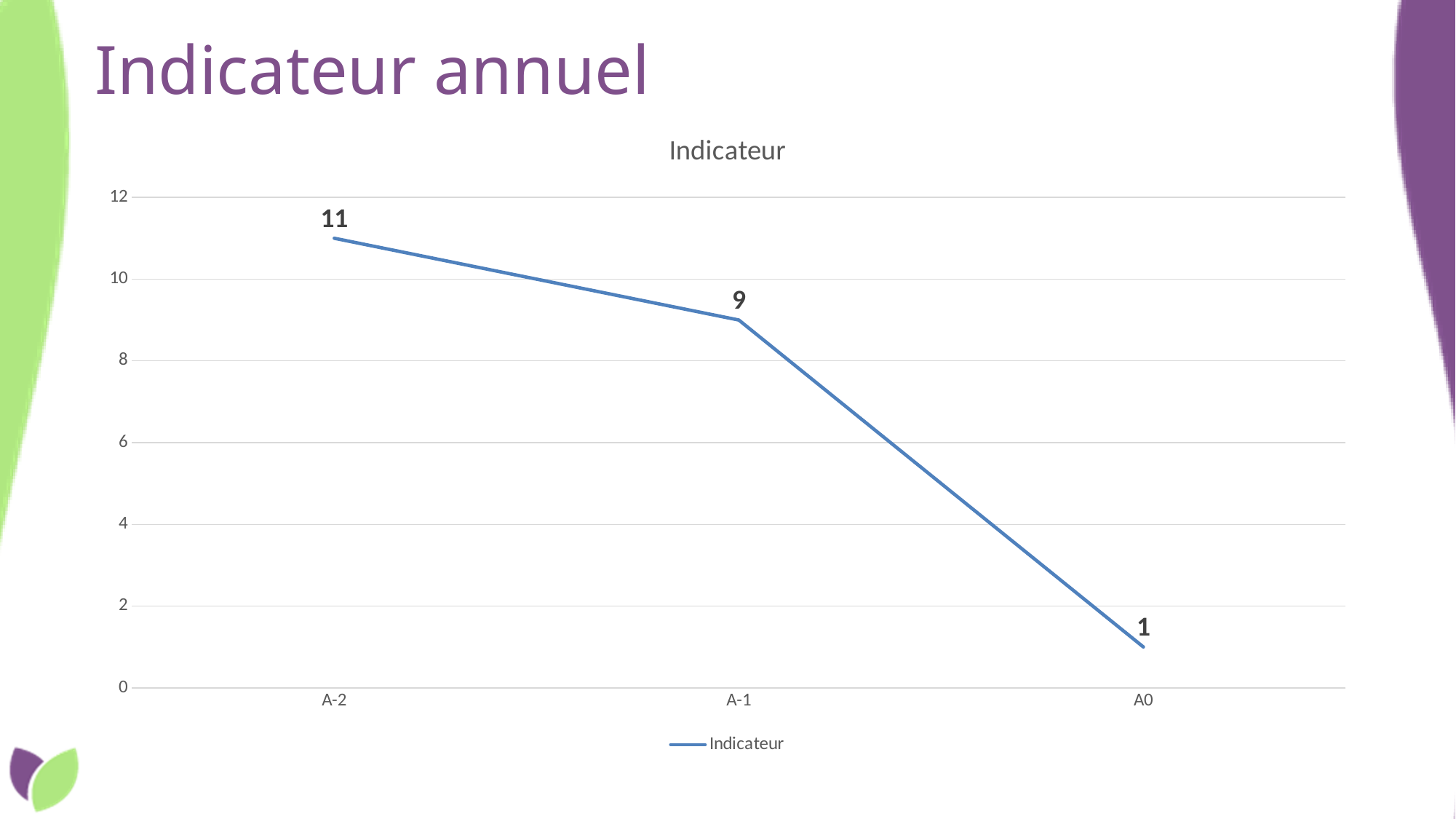
Which category has the highest Indicateur value? A-2 How many categories are shown on the x axis? 3 What is the difference between the Indicateur values for A-1 and A0? 8 What is the value of Indicateur for A-1? 9 Do the values rise or fall from A-2 to A0? fall What is the value of Indicateur for A-2? 11 What is the difference between the Indicateur values for A-2 and A0? 10 What kind of chart is shown on the slide? line chart Which is larger, the Indicateur value for A-1 or for A0? A-1 Is the value for A-1 greater or less than 8? greater Which category has the lowest Indicateur value? A0 What is the value of Indicateur for A0? 1